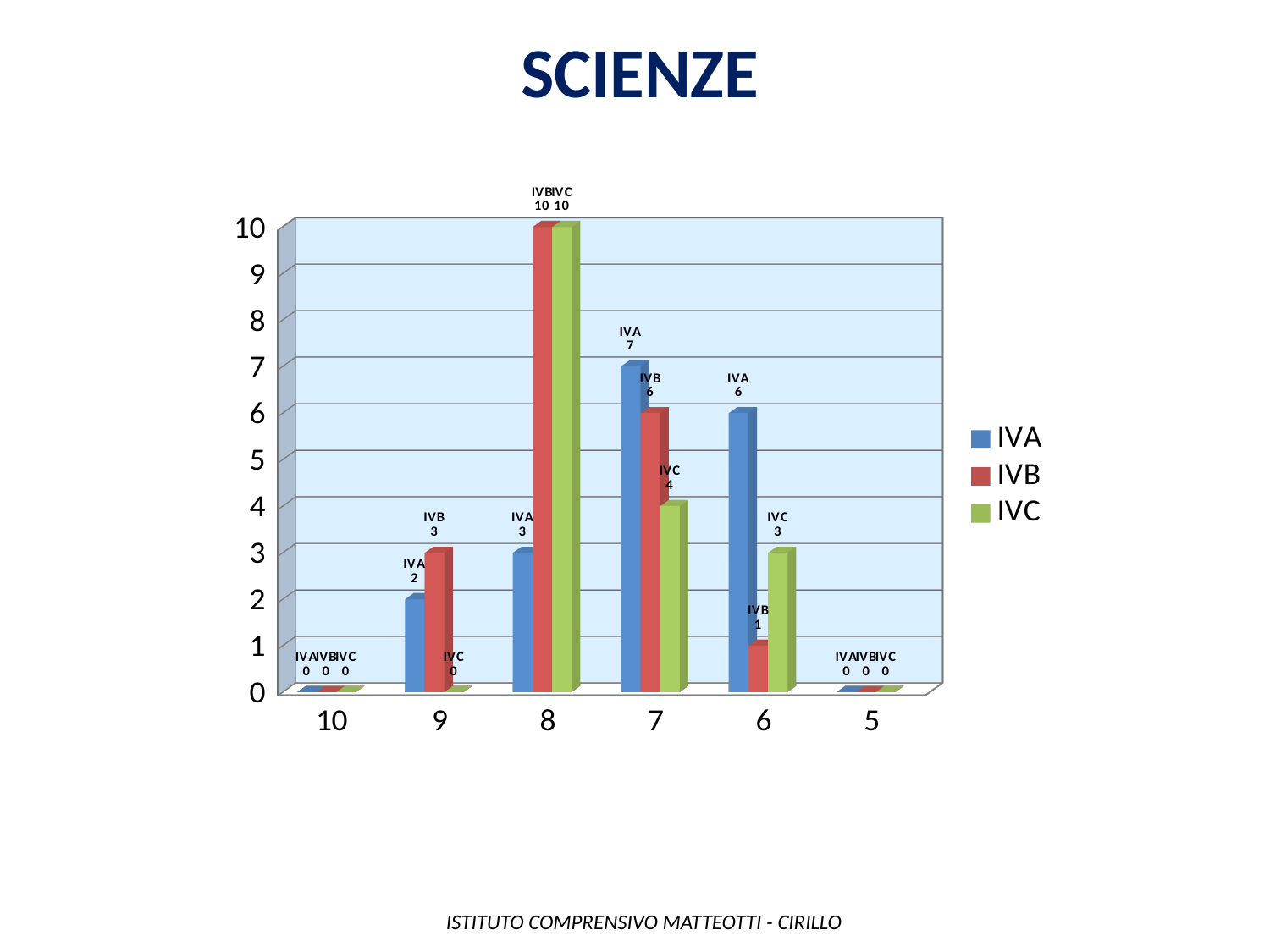
What is the difference between the IVA and IVB values at category 6? 5 How many categories are shown on the x axis? 6 Which is larger at category 7, the IVB value or the IVC value? IVB What is the value for IVB at category 8? 10 How many series does the legend list? 3 What is the value for IVC at category 9? 0 What is the value for IVA at category 7? 7 What kind of chart is shown on the slide? bar chart Which category has the highest value for the IVA series? 7 What is the value for IVC at category 6? 3 What is the value for IVB at category 9? 3 What is the title of the chart? SCIENZE